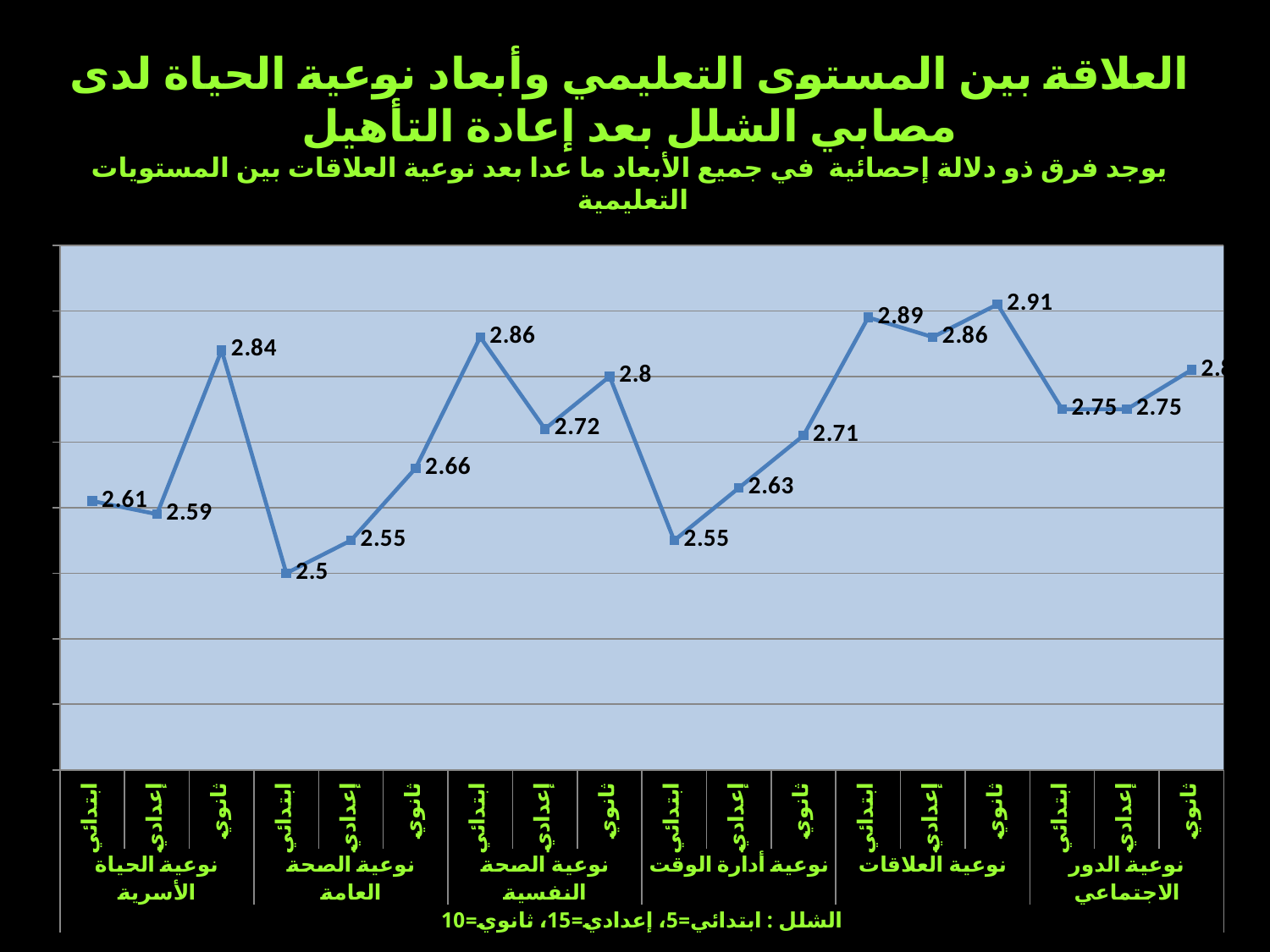
Which is larger: the ابتدائي value under نوعية الصحة النفسية or the ابتدائي value under نوعية أدارة الوقت? نوعية الصحة النفسية (2.86) What is the value for ثانوي under نوعية أدارة الوقت? 2.71 What is the value for إعدادي under نوعية الصحة النفسية? 2.72 What is the value for ابتدائي under نوعية الصحة العامة? 2.5 What is the difference between the ثانوي and ابتدائي values under نوعية الحياة الأسرية? 0.23 Which point has the lowest value on the chart? ابتدائي under نوعية الصحة العامة (2.5) What kind of chart is shown on the slide? line chart How many quality-of-life dimensions are shown along the x axis? 6 What is the value for ثانوي under نوعية الحياة الأسرية? 2.84 Which point has the highest value on the chart? ثانوي under نوعية العلاقات (2.91) Do the values rise or fall from ابتدائي to ثانوي within نوعية الصحة العامة? rise How many data points are plotted on the chart? 18